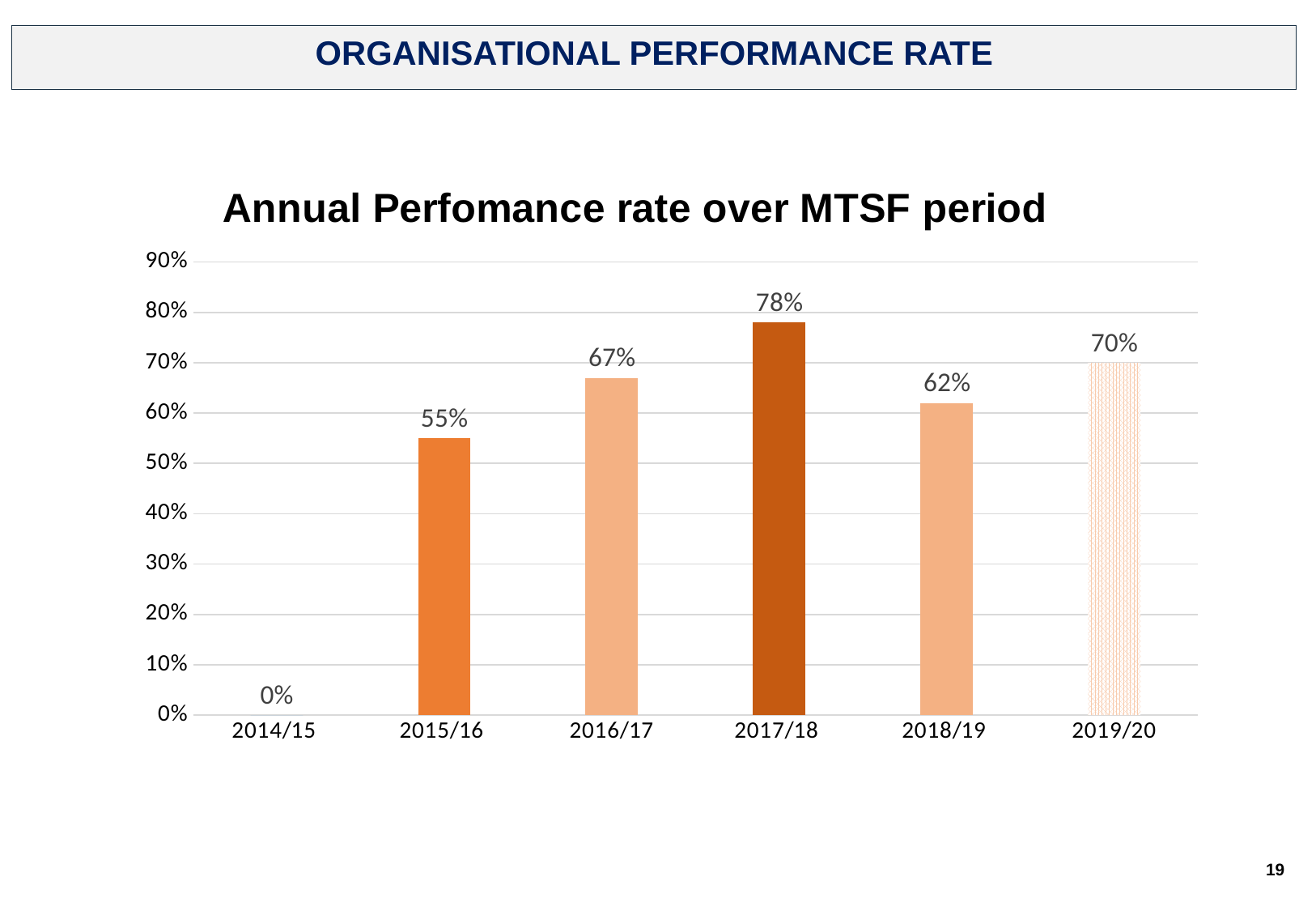
Which year has the highest annual performance rate? 2017/18 What is the difference between the performance rates for 2017/18 and 2018/19? 16% What is the annual performance rate for 2017/18? 78% What kind of chart is shown on the slide? bar chart Which year has a higher performance rate, 2016/17 or 2019/20? 2019/20 What is the annual performance rate for 2015/16? 55% Is the value for 2018/19 greater or less than 70%? less What is the annual performance rate for 2019/20? 70% How many years are shown on the x axis? 6 What is the title of the chart? Annual Perfomance rate over MTSF period Which year has the lowest annual performance rate? 2014/15 Does the performance rate rise or fall from 2015/16 to 2017/18? rise